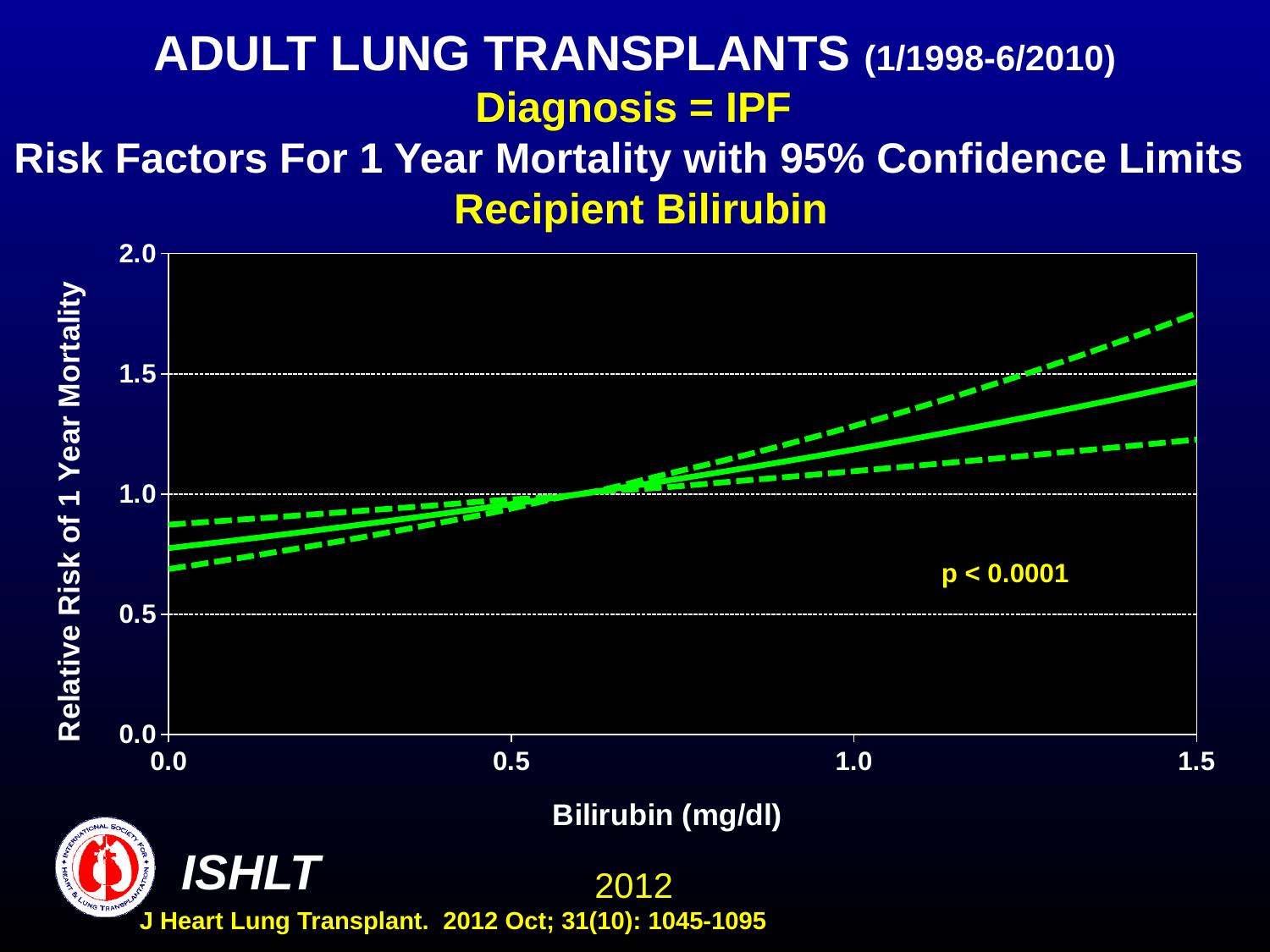
Is the relative risk of 1 year mortality (solid line) at a bilirubin of 0.5 mg/dl greater or less than 1.0? less Is the relative risk of 1 year mortality (solid line) at a bilirubin of 1.0 mg/dl greater or less than 1.0? greater How many lines are plotted on the chart? 3 Does the relative risk of 1 year mortality rise or fall as bilirubin increases along the x axis? rise Is the lower 95% confidence limit (lower dashed line) at a bilirubin of 1.5 mg/dl greater or less than 1.5? less What kind of chart is shown on the slide? line chart What is the label of the x axis? Bilirubin (mg/dl) What is the maximum value shown on the y axis? 2.0 What p-value is printed on the chart? p < 0.0001 What is the label of the y axis? Relative Risk of 1 Year Mortality